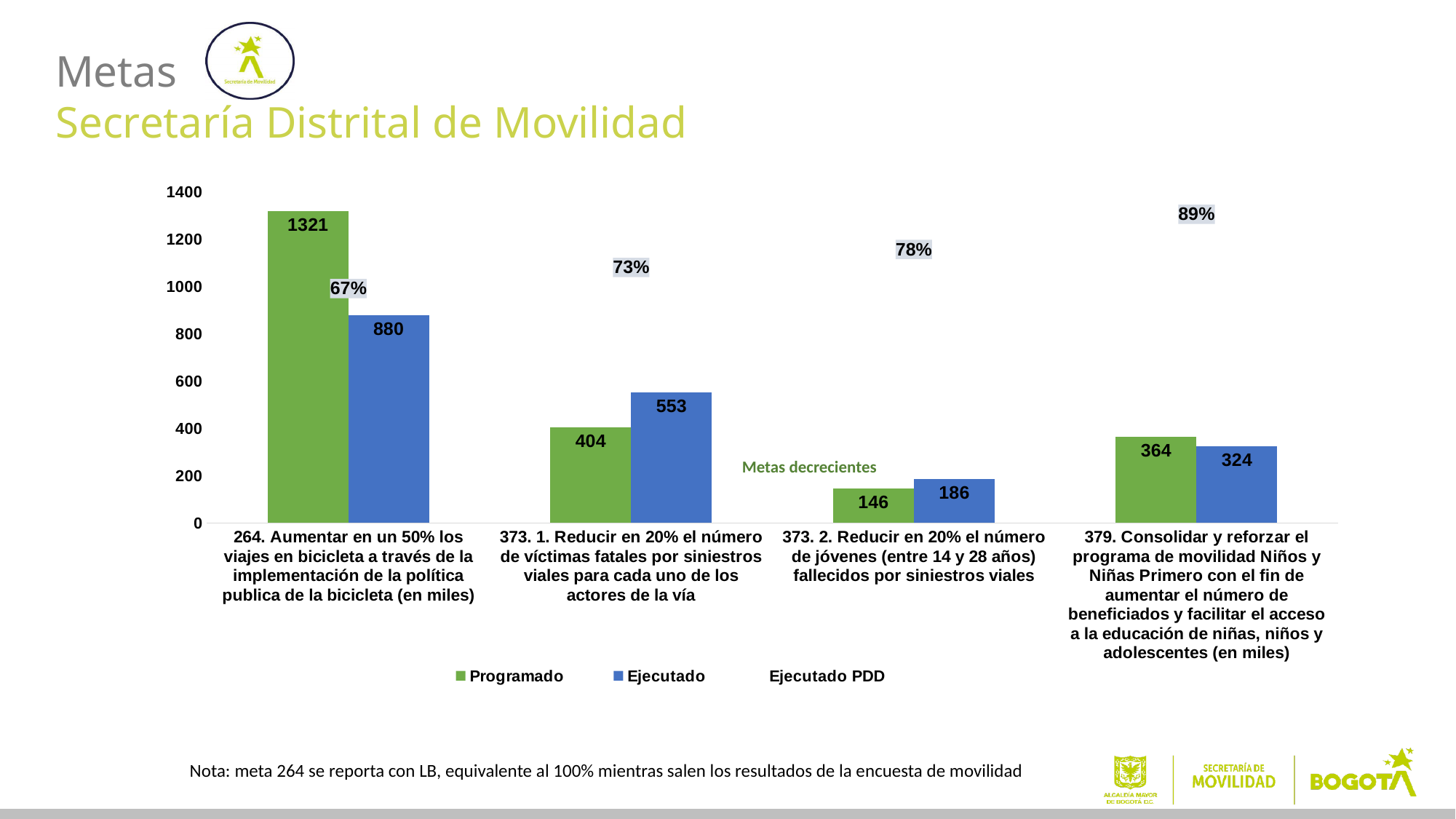
What is the Ejecutado value for meta 373. 1 (Reducir en 20% el número de víctimas fatales por siniestros viales)? 553 What is the Programado value for meta 373. 2 (Reducir en 20% el número de jóvenes fallecidos por siniestros viales)? 146 Which meta has the lowest Ejecutado value? 373. 2. Reducir en 20% el número de jóvenes (entre 14 y 28 años) fallecidos por siniestros viales For meta 373. 1, which is larger, the Programado or the Ejecutado value? Ejecutado What is the difference between the Programado and Ejecutado values for meta 264? 441 Which meta has the highest Programado value? 264. Aumentar en un 50% los viajes en bicicleta What is the Ejecutado PDD percentage shown for meta 379 (Consolidar y reforzar el programa de movilidad Niños y Niñas Primero)? 89% What is the Programado value for meta 264 (Aumentar en un 50% los viajes en bicicleta)? 1321 How many series does the legend list? 3 What type of chart is shown on the slide? Bar chart Is the Ejecutado value for meta 264 greater or less than 1000? less How many metas (categories) are shown on the x axis of the chart? 4